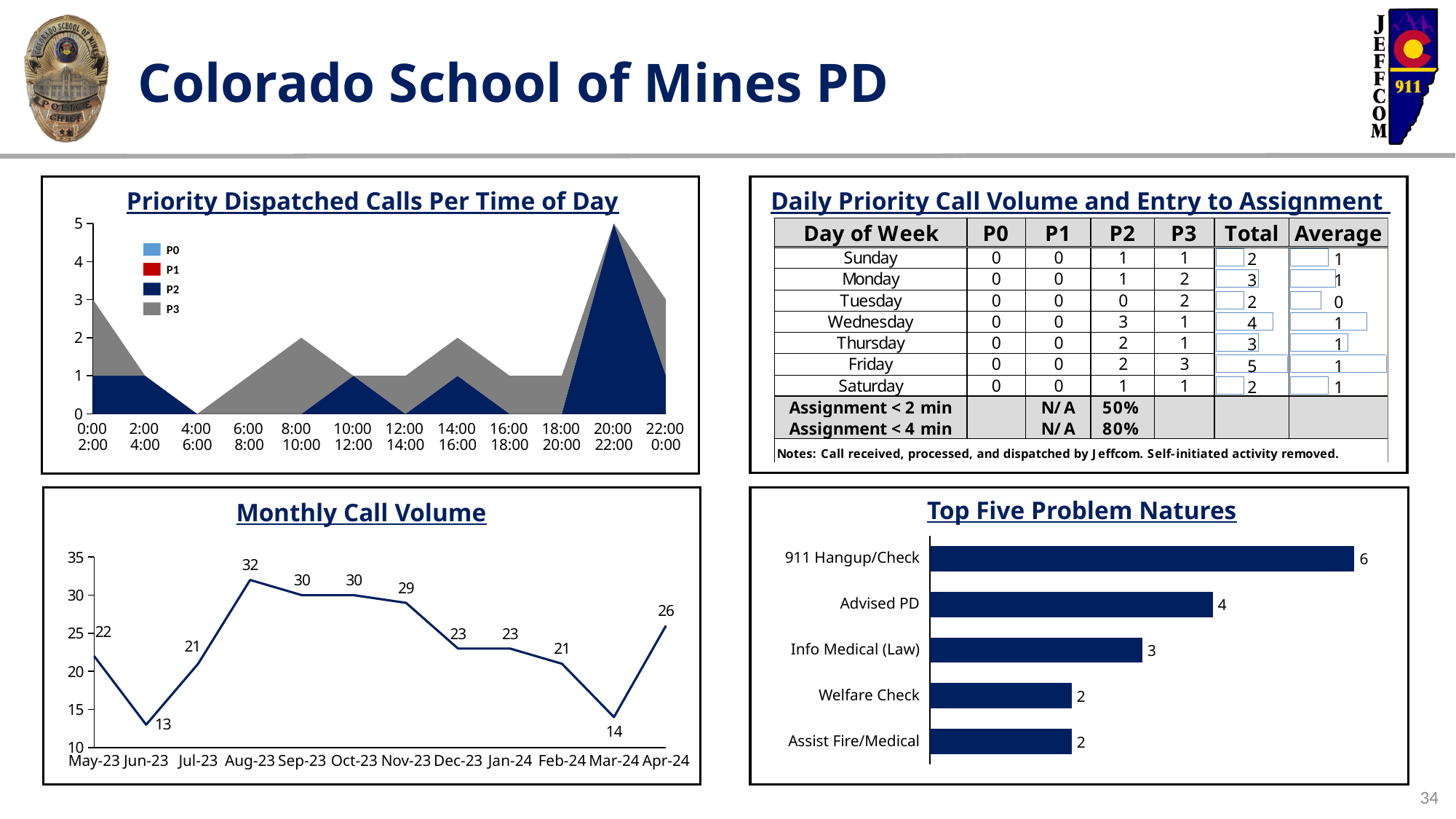
In the Top Five Problem Natures chart, how many problem natures are shown? 5 In the Monthly Call Volume chart, which month has the highest call volume? Aug-23 In the Monthly Call Volume chart, is the call volume higher in May-23 or Jul-23? May-23 In the Monthly Call Volume chart, what is the difference between the call volumes for Apr-24 and Mar-24? 12 How many series does the legend of the Priority Dispatched Calls Per Time of Day chart list? 4 In the Monthly Call Volume chart, which month has the lowest call volume? Jun-23 In the Priority Dispatched Calls Per Time of Day chart, which time slot has the highest value? 20:00-22:00 In the Top Five Problem Natures chart, what is the value for 911 Hangup/Check? 6 What kind of chart is the Top Five Problem Natures chart? Bar chart In the Top Five Problem Natures chart, what is the difference between Advised PD and Info Medical (Law)? 1 In the Monthly Call Volume chart, how many months are plotted? 12 In the Monthly Call Volume chart, what is the call volume for Aug-23? 32